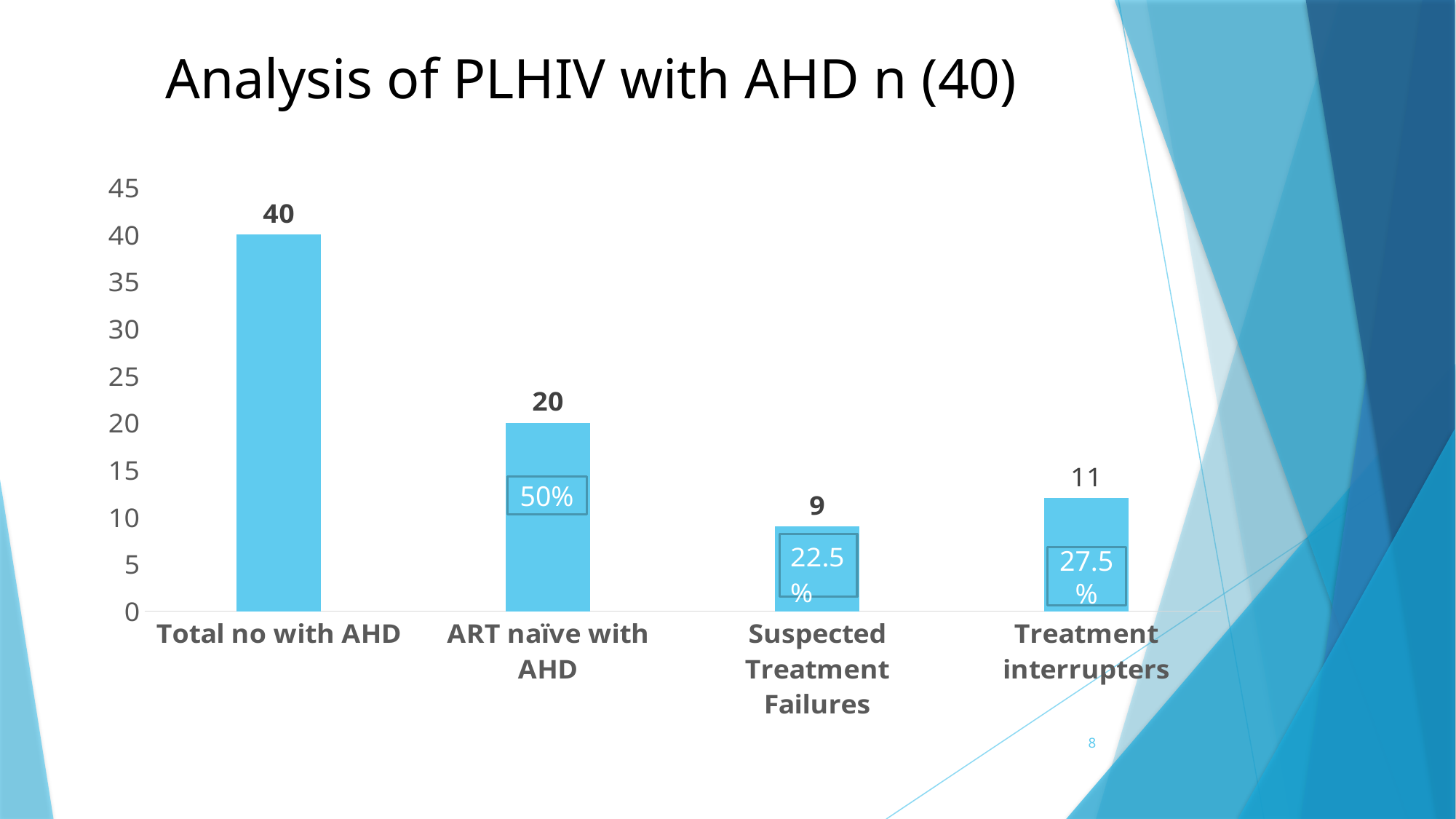
What percentage label is shown inside the bar for ART naïve with AHD? 50% What is the difference between the values for Total no with AHD and ART naïve with AHD? 20 What is the value for Treatment interrupters? 11 What is the value for Total no with AHD? 40 Which category has the highest value? Total no with AHD Which is larger, the value for Treatment interrupters or the value for Suspected Treatment Failures? Treatment interrupters What kind of chart is shown on the slide? bar chart What is the value for Suspected Treatment Failures? 9 Which category has the lowest value? Suspected Treatment Failures How many categories are shown on the x axis? 4 What is the value for ART naïve with AHD? 20 Is the value for Treatment interrupters greater or less than 15? less